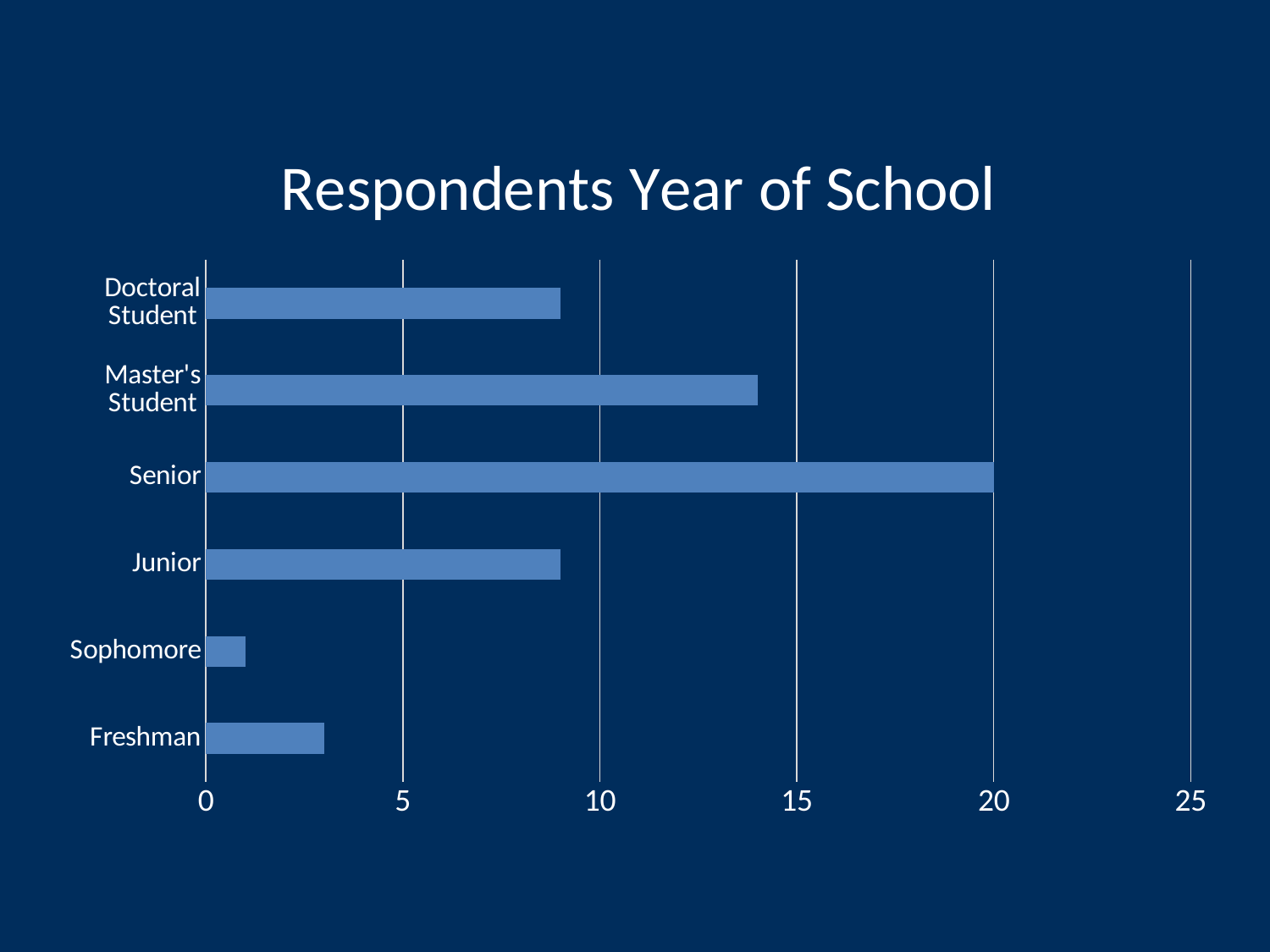
What is the title of the chart? Respondents Year of School Is the value for Sophomore greater or less than 5? less Is the value for Freshman greater or less than 5? less Which has more respondents, Master's Student or Freshman? Master's Student Which category has the lowest number of respondents? Sophomore How many year-of-school categories are shown in the chart? 6 Which category has the highest number of respondents? Senior Is the value for Doctoral Student greater or less than 10? less Which has more respondents, Senior or Junior? Senior What is the value for Senior? 20 What kind of chart is shown on the slide? bar chart